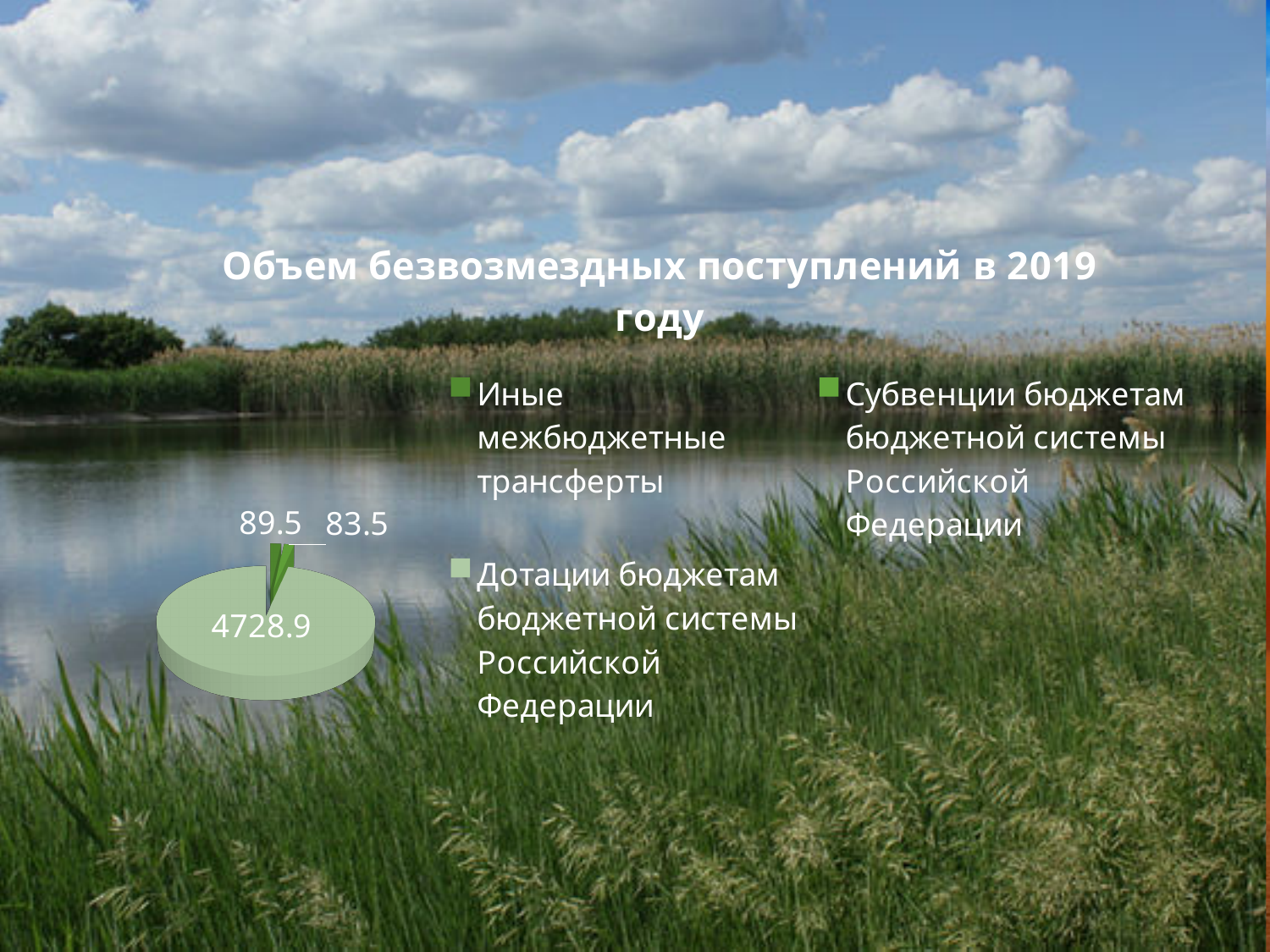
How many slices does the pie chart have? 3 What is the difference between the two small slices labelled 89.5 and 83.5? 6 What is the smallest value shown on the pie chart? 83.5 How many entries does the legend list? 3 What is the value for Дотации бюджетам бюджетной системы Российской Федерации? 4728.9 What kind of chart is shown on the slide? pie chart What is the total of all three values shown on the pie chart? 4901.9 What is the difference between the largest slice (4728.9) and the slice labelled 89.5? 4639.4 What is the title of the chart? Объем безвозмездных поступлений в 2019 году Which category has the largest slice of the pie? Дотации бюджетам бюджетной системы Российской Федерации What is the value of the largest slice in the pie chart? 4728.9